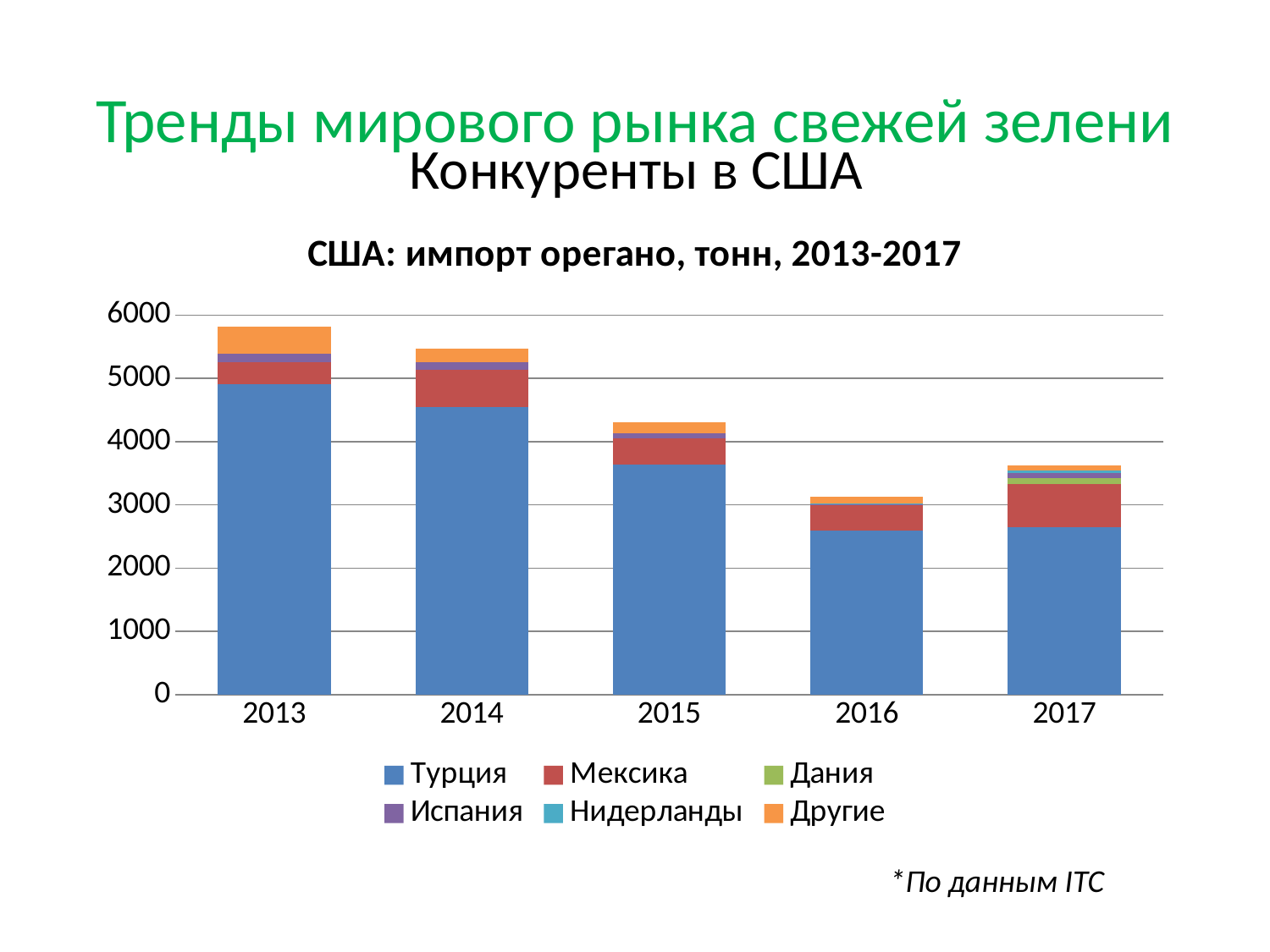
Which year has the lowest total bar? 2016 Do the total bars rise or fall from 2013 to 2016? fall Which year has the highest total bar? 2013 Which series forms the largest segment in every bar? Турция What kind of chart is shown on the slide? Stacked bar chart Which year has a larger total bar, 2013 or 2017? 2013 Is the Турция segment for 2016 greater or less than 2000? greater How many series does the chart legend list? 6 What is the title of the chart? США: импорт орегано, тонн, 2013-2017 Is the total bar for 2017 greater or less than 4000? less Is the total bar for 2013 greater or less than 5000? greater How many years are shown on the x axis of the chart? 5